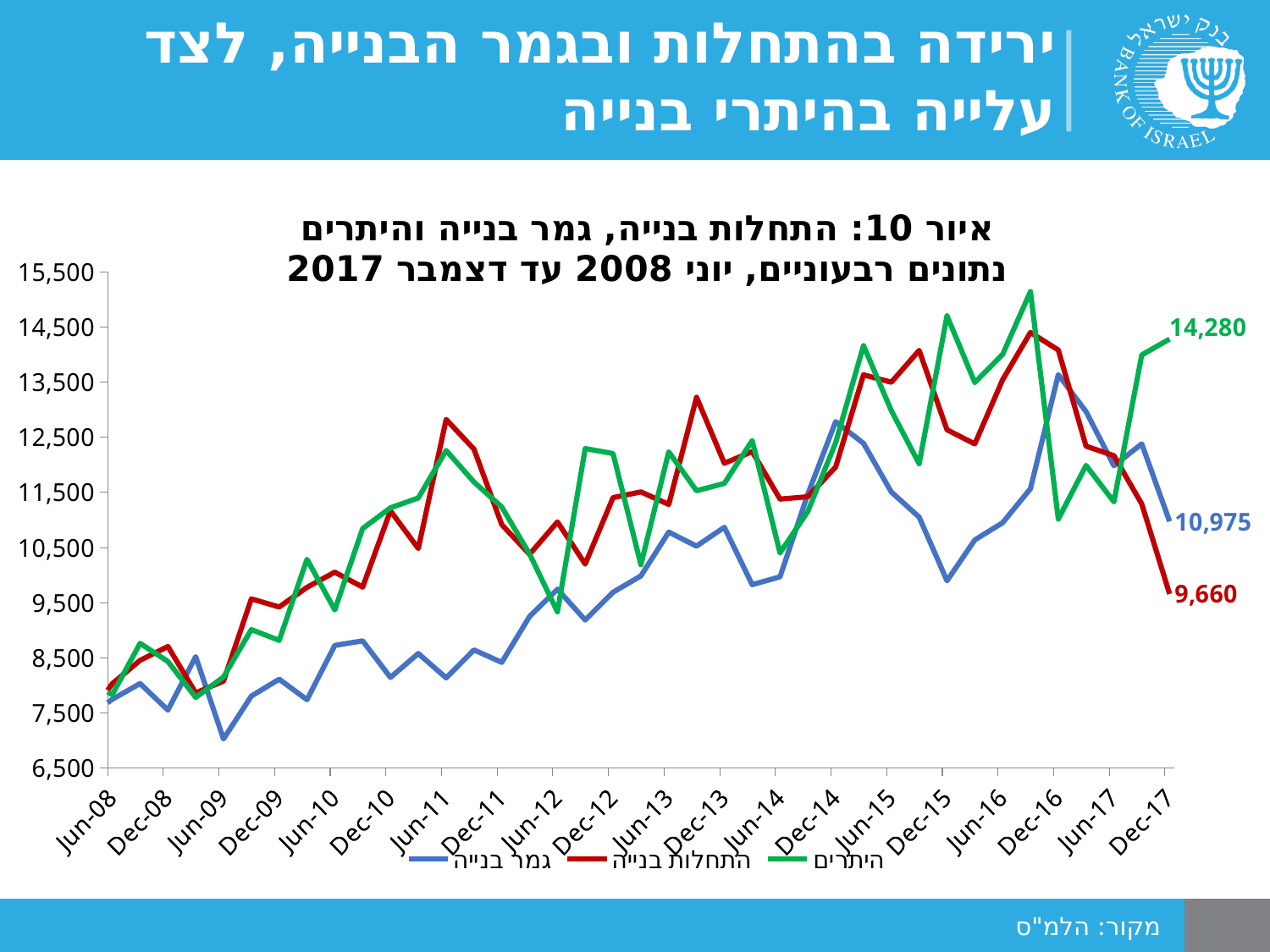
How many series does the legend list? 3 Does the התחלות בנייה line rise or fall between Dec-16 and Dec-17? fall Which series has the lowest value at Dec-17? התחלות בנייה Is the value for גמר בנייה at Jun-09 greater or less than 7,500? less What is the value of גמר בנייה at Dec-17? 10,975 What is the difference between היתרים and גמר בנייה at Dec-17? 3,305 What kind of chart is shown on the slide? line chart At Dec-17, which is larger: היתרים or התחלות בנייה? היתרים What colour is the line for היתרים? green What is the value of היתרים at Dec-17? 14,280 What is the value of התחלות בנייה at Dec-17? 9,660 What is the difference between היתרים and התחלות בנייה at Dec-17? 4,620